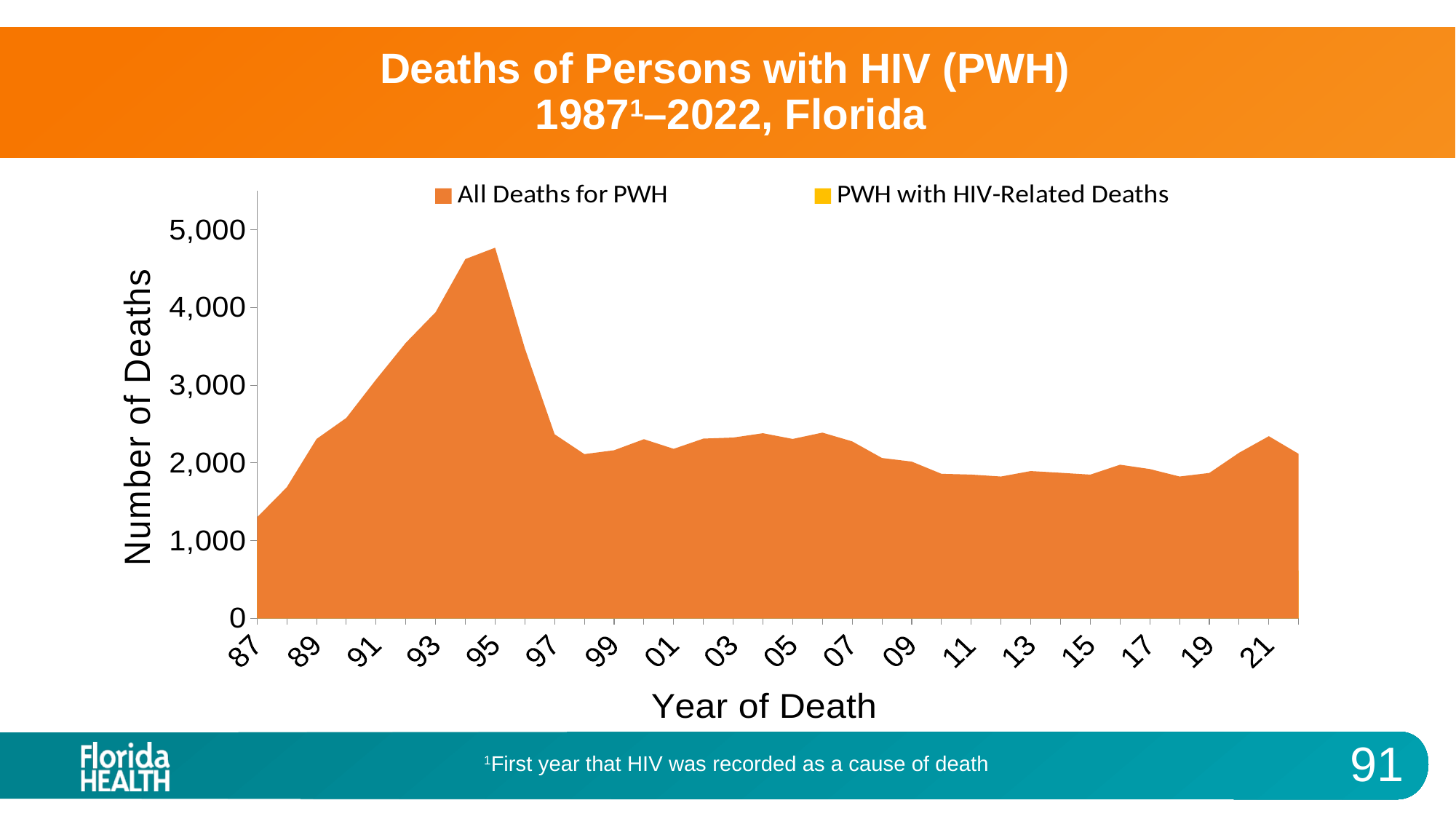
Which year has more All Deaths for PWH, 95 or 21? 95 In which year is the number of All Deaths for PWH lowest? 87 Do the values for All Deaths for PWH rise or fall from 87 to 95? rise What is the title of the y axis? Number of Deaths Is the value for All Deaths for PWH in 95 greater or less than 4,000? greater What kind of chart is shown on the slide? Area chart Is the value for All Deaths for PWH in 87 greater or less than 2,000? less How many series does the legend list? 2 Is the value for All Deaths for PWH in 11 greater or less than 2,000? less Do the values for All Deaths for PWH rise or fall from 95 to 97? fall In which year is the number of All Deaths for PWH highest? 95